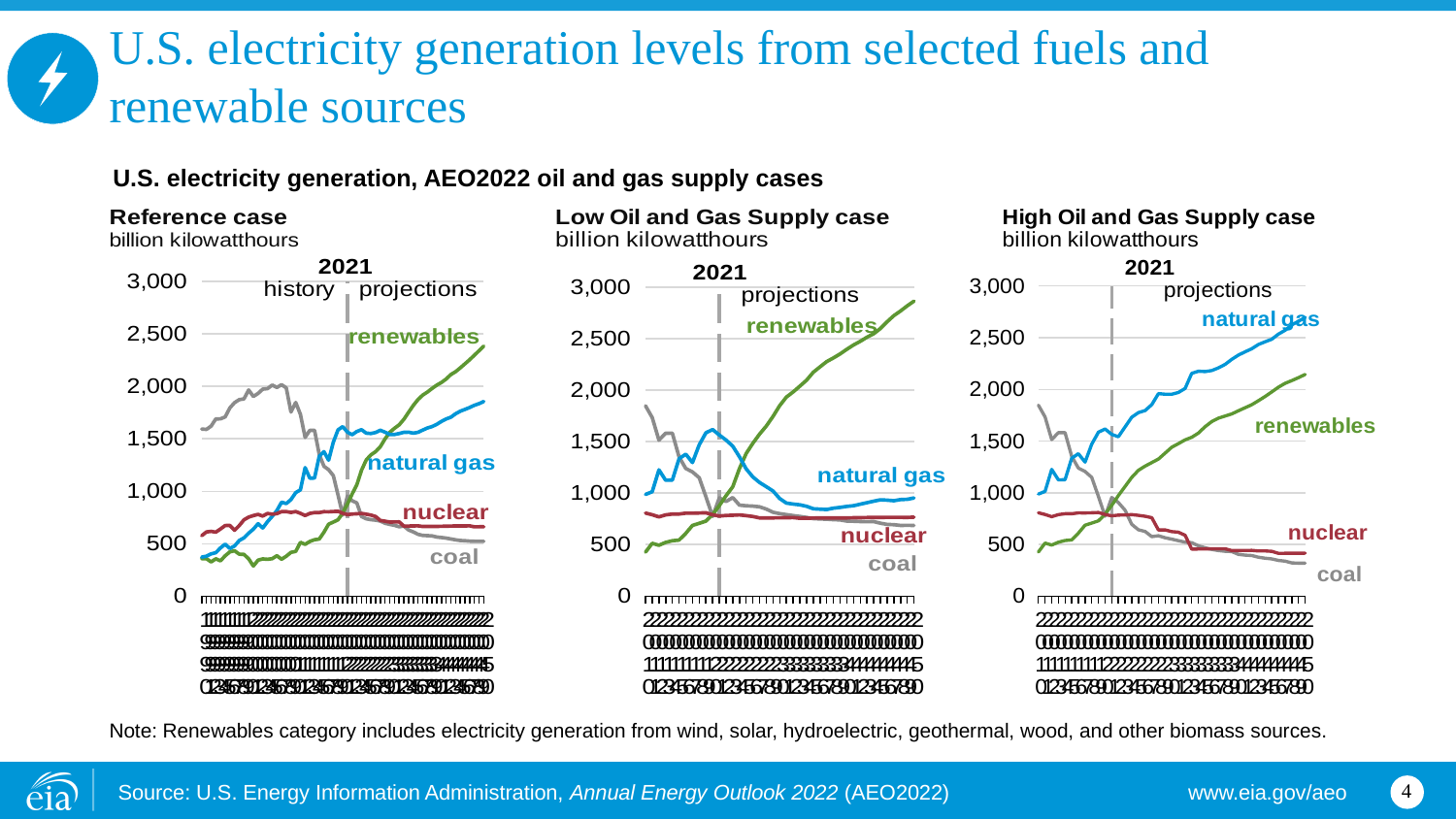
In the Reference case chart, is the value for renewables at the end of the projection period greater or less than 2,000? greater What unit is used on the y axis of the three charts? billion kilowatthours In the High Oil and Gas Supply case chart, is the value for coal at the end of the projection period greater or less than 500? less In the Low Oil and Gas Supply case chart, is the value for renewables at the end of the projection period greater or less than 2,500? greater What kind of chart is the Reference case chart? line chart How many charts are shown on the slide? 3 How many labelled series does the Low Oil and Gas Supply case chart show? 4 In the High Oil and Gas Supply case chart, which series has the highest value at the end of the projection period? natural gas In the High Oil and Gas Supply case chart, does the coal series rise or fall over the projection period? fall In the Low Oil and Gas Supply case chart, which is larger at the end of the projection period, renewables or natural gas? renewables